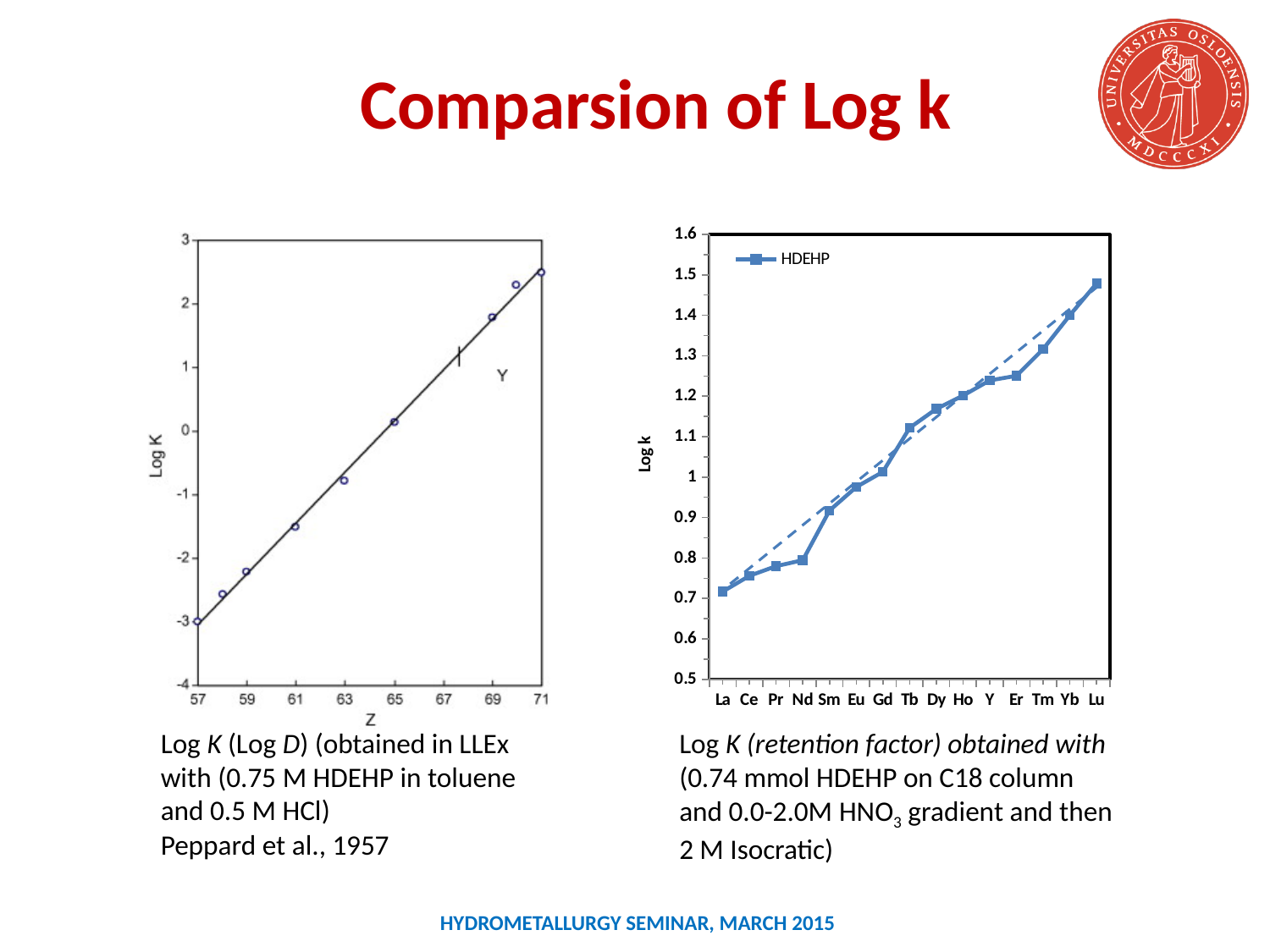
How many elements are plotted along the x axis of the right chart? 15 In the right chart, do the Log k values generally rise or fall from La to Lu? rise In the right chart (Log k vs lanthanides), which element has the highest Log k value? Lu In the right chart, which has the larger Log k value, Sm or Nd? Sm In the right chart, is the Log k value for Lu greater or less than 1.4? greater In the right chart (Log k vs lanthanides), which element has the lowest Log k value? La In the right chart, is the Log k value for Tb greater or less than 1.1? greater In the left chart (Log K vs Z), is the Log K value at Z = 57 greater or less than -2? less What kind of chart is the left chart (Log K vs Z)? scatter plot How many series does the legend of the right chart list? 1